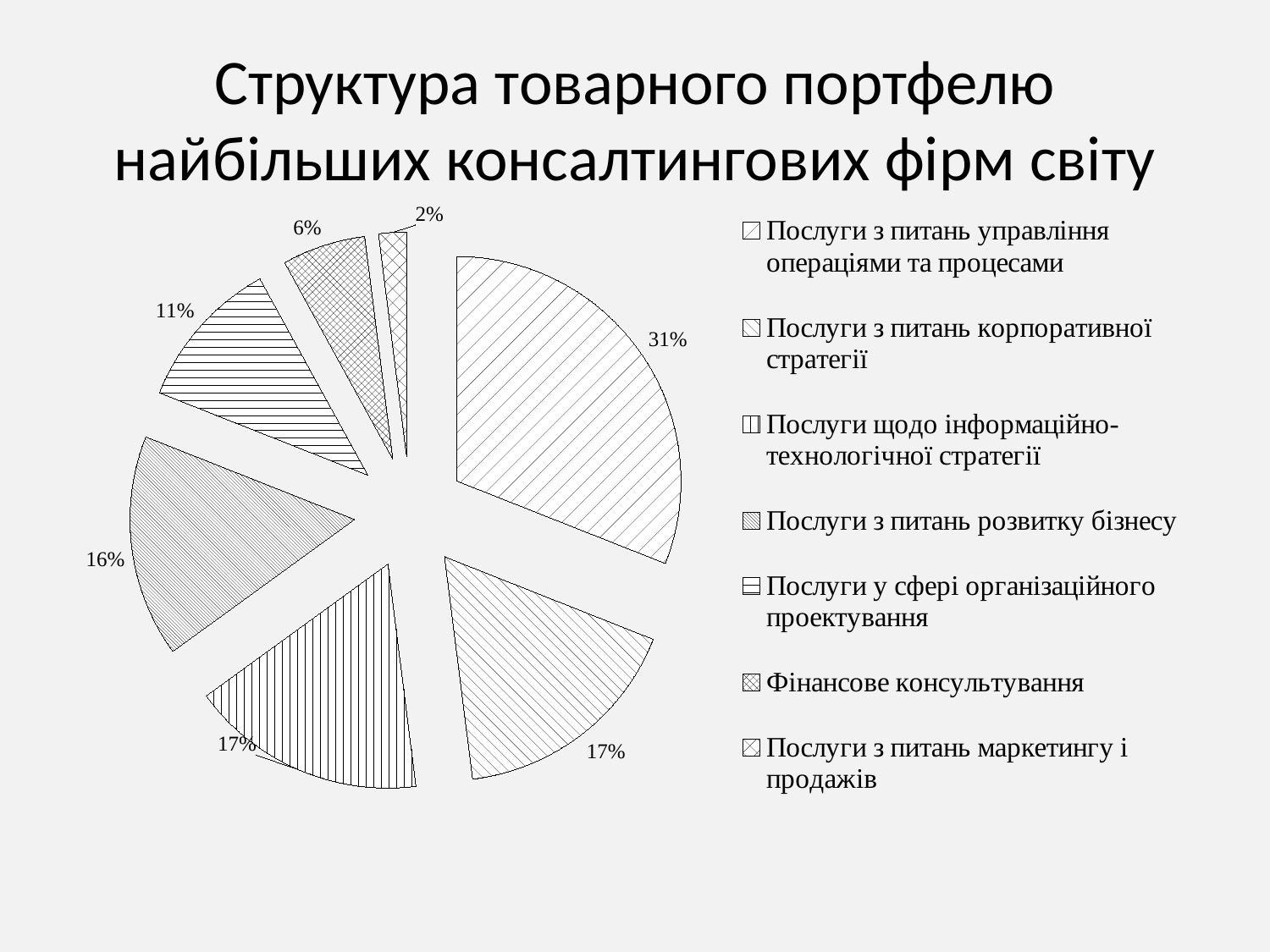
What is the difference in percentage points between 'Послуги з питань управління операціями та процесами' and 'Послуги з питань розвитку бізнесу'? 15 What share of the pie is 'Послуги у сфері організаційного проектування'? 11% Which is larger: the share for 'Послуги у сфері організаційного проектування' or the share for 'Фінансове консультування'? Послуги у сфері організаційного проектування What share of the pie is 'Послуги з питань розвитку бізнесу'? 16% What share of the pie is 'Послуги з питань управління операціями та процесами'? 31% Which category has the smallest share of the pie? Послуги з питань маркетингу і продажів What kind of chart is shown on the slide? pie chart What is the title of the slide? Структура товарного портфелю найбільших консалтингових фірм світу Which category has the largest share of the pie? Послуги з питань управління операціями та процесами How many slices does the pie chart have? 7 How many entries does the legend list? 7